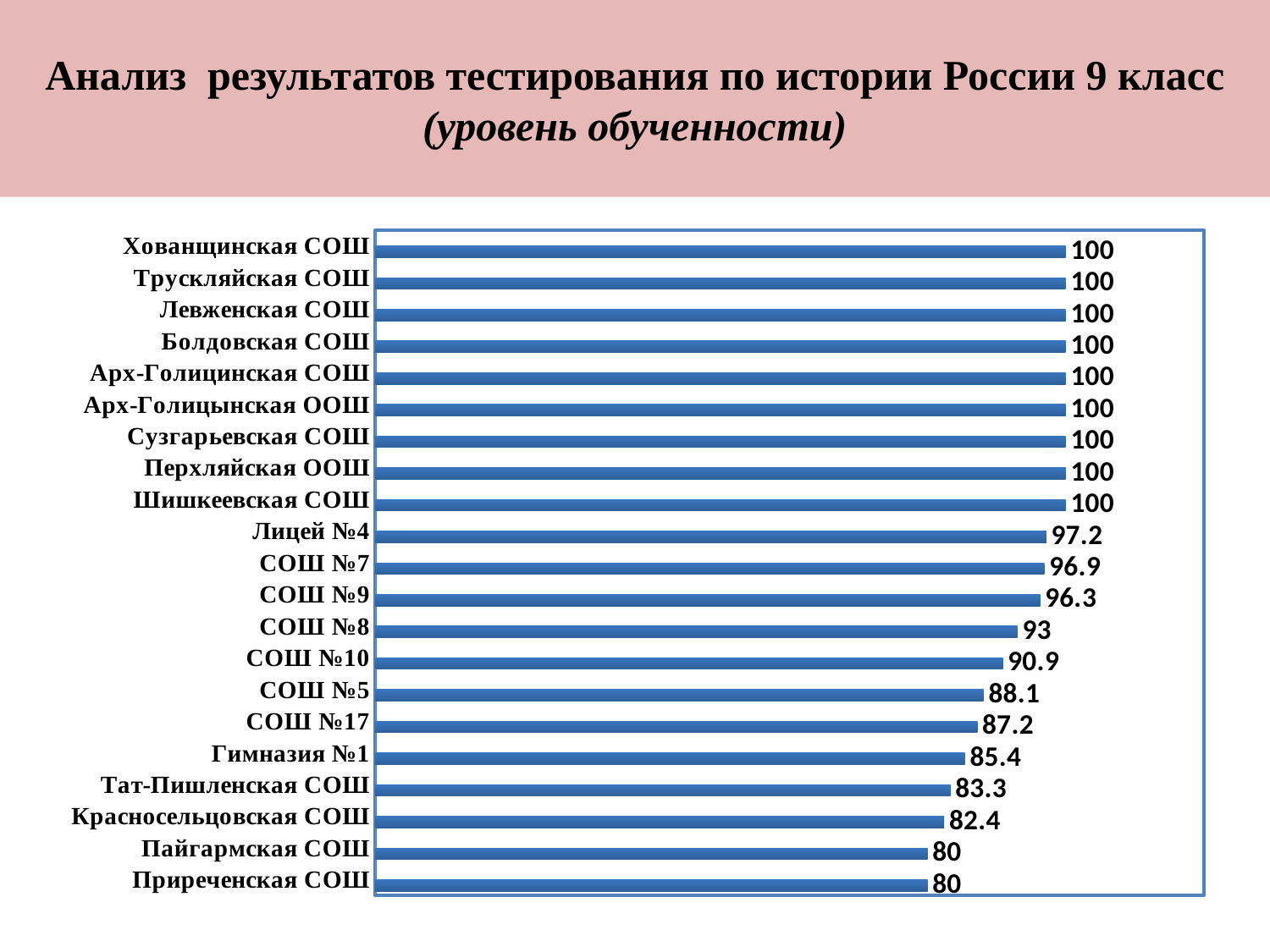
How many schools are shown in the chart? 21 What is the highest value shown in the chart? 100 What is the difference between the values for СОШ №8 and СОШ №5? 4.9 What is the value for Красносельцовская СОШ? 82.4 What is the value for Лицей №4? 97.2 What kind of chart is shown on the slide? bar chart What is the value for СОШ №10? 90.9 What is the lowest value shown in the chart? 80 How many schools have a value of 100? 9 What is the value for Гимназия №1? 85.4 Which has a larger value, СОШ №17 or Тат-Пишленская СОШ? СОШ №17 What is the difference between the values for Лицей №4 and Приреченская СОШ? 17.2